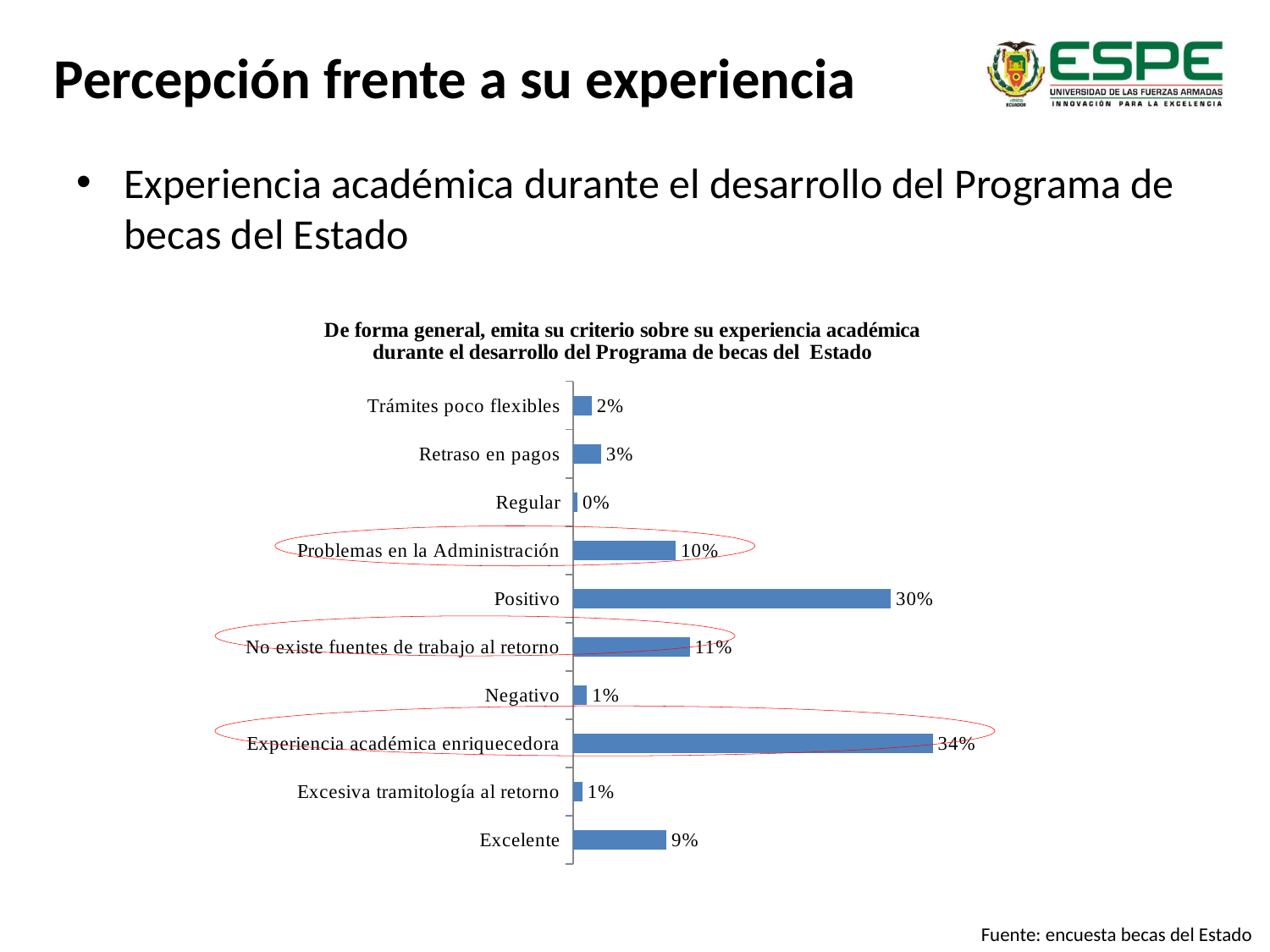
How many categories are shown in the chart? 10 What is the difference between the values for Experiencia académica enriquecedora and Positivo? 4% What is the difference between the values for No existe fuentes de trabajo al retorno and Problemas en la Administración? 1% What is the value for No existe fuentes de trabajo al retorno? 11% What is the value for Positivo? 30% Which category has the highest value? Experiencia académica enriquecedora Which category has the lowest value? Regular What is the value for Excelente? 9% What is the source cited for the chart data? Fuente: encuesta becas del Estado What is the value for Problemas en la Administración? 10% What kind of chart is shown on the slide? Bar chart Which is larger, the value for Retraso en pagos or the value for Trámites poco flexibles? Retraso en pagos